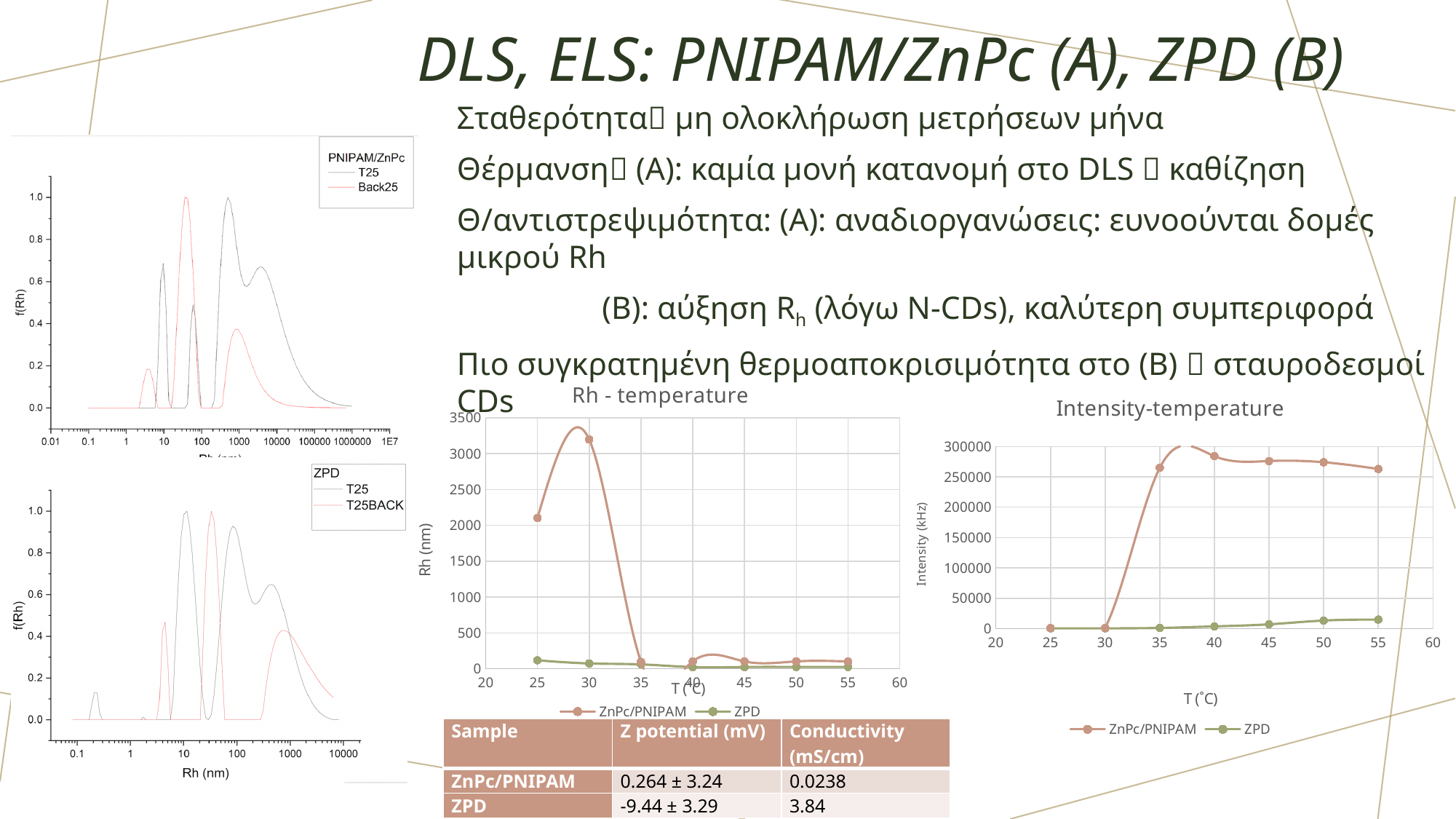
What kind of chart is the 'Rh - temperature' chart? line chart In the 'Rh - temperature' chart, which series has the higher value at 30 °C, ZnPc/PNIPAM or ZPD? ZnPc/PNIPAM In the 'Rh - temperature' chart, is the Rh value for ZnPc/PNIPAM at 35 °C greater or less than 500? less In the 'Rh - temperature' chart, how many temperature points are plotted for each series? 7 In the 'Intensity-temperature' chart, which series has the higher value at 50 °C, ZnPc/PNIPAM or ZPD? ZnPc/PNIPAM In the 'Intensity-temperature' chart, what are the two legend entries? ZnPc/PNIPAM and ZPD In the 'Rh - temperature' chart, is the Rh value for ZnPc/PNIPAM at 30 °C greater or less than 3000? greater In the 'Rh - temperature' chart, is the Rh value for ZnPc/PNIPAM at 25 °C greater or less than 2000? greater In the 'Intensity-temperature' chart, what is the label of the y axis? Intensity (kHz) In the 'Rh - temperature' chart, how many series does the legend list? 2